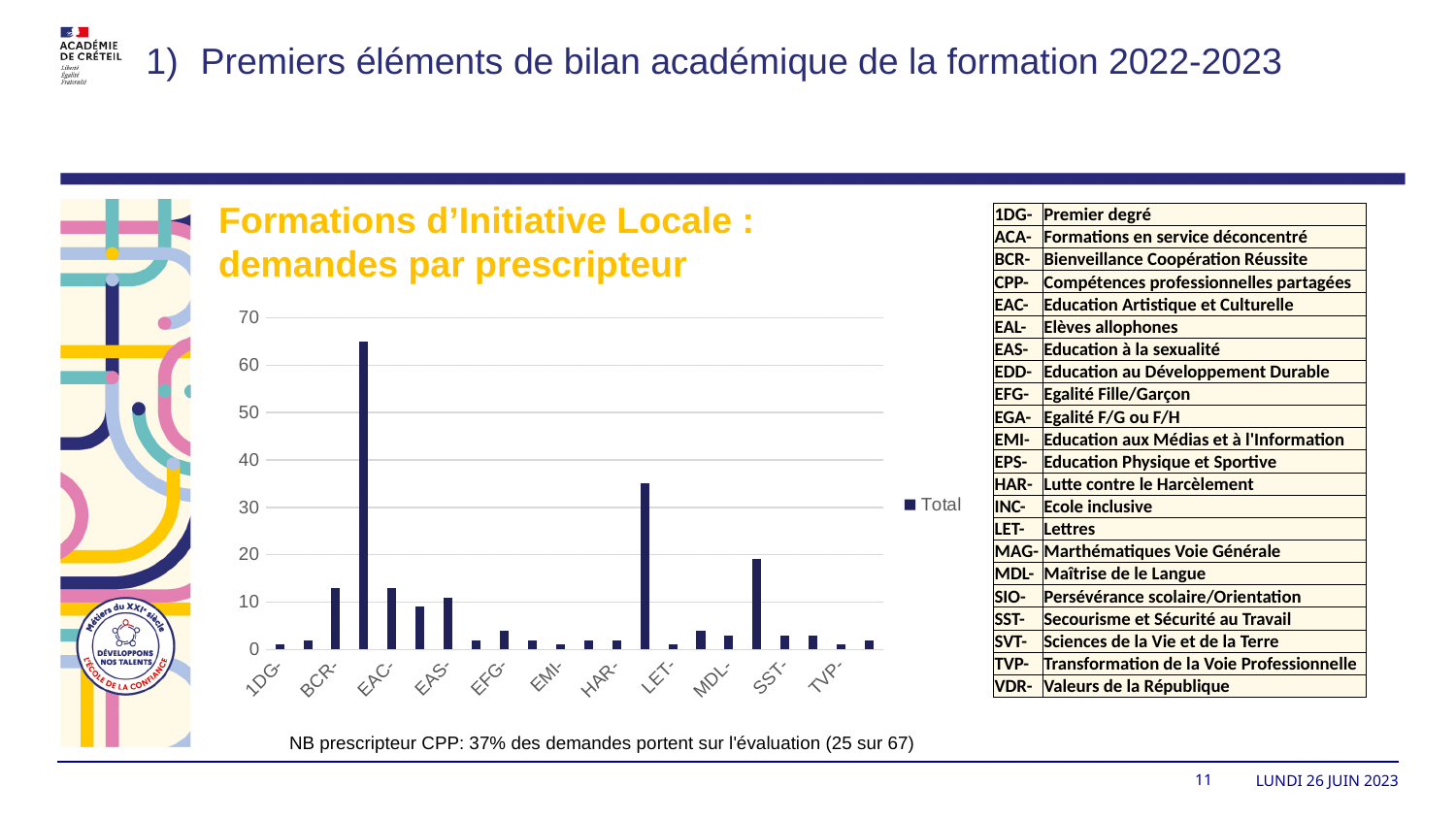
What is the highest value shown on the vertical axis? 70 Is the value for EFG- greater or less than 10? less What kind of chart is shown on the slide? bar chart Is the tallest bar in the chart greater or less than 60? greater Is the value for BCR- greater or less than 10? greater Which has a larger value, EAC- or EFG-? EAC- What is the name of the series shown in the chart legend? Total What is the title of the chart? Formations d'Initiative Locale : demandes par prescripteur Which has a larger value, BCR- or HAR-? BCR- How many series does the chart legend list? 1